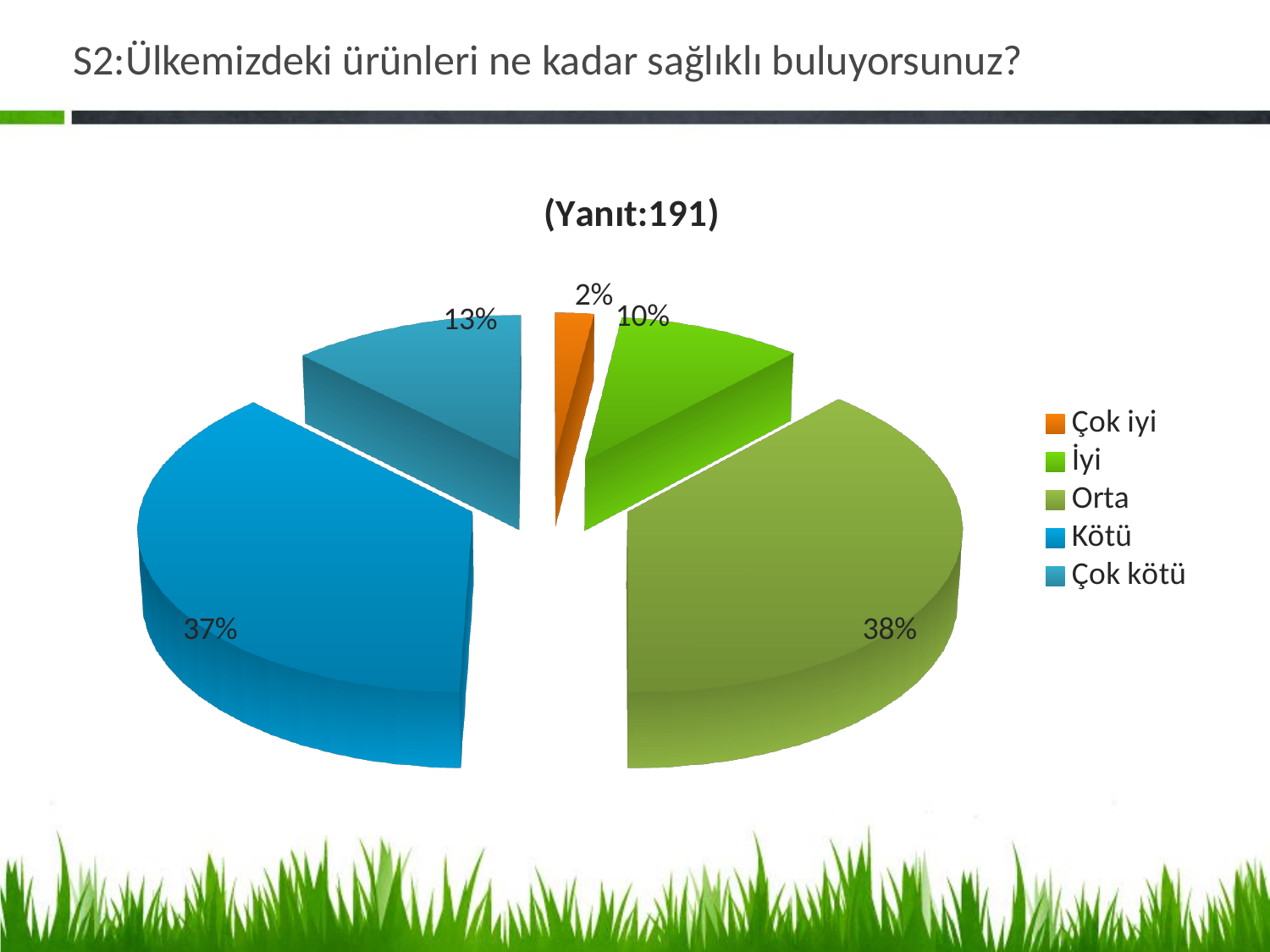
Which is larger, the share for Kötü or the share for Çok kötü? Kötü Which category has the smallest slice? Çok iyi What is the difference between the shares of Çok kötü and İyi? 3% What share of the pie does Kötü have? 37% What share of the pie does Orta have? 38% How many categories does the legend list? 5 What share of the pie does Çok iyi have? 2% Which category has the largest slice? Orta What is the chart's title? (Yanıt:191) What kind of chart is shown on the slide? pie chart